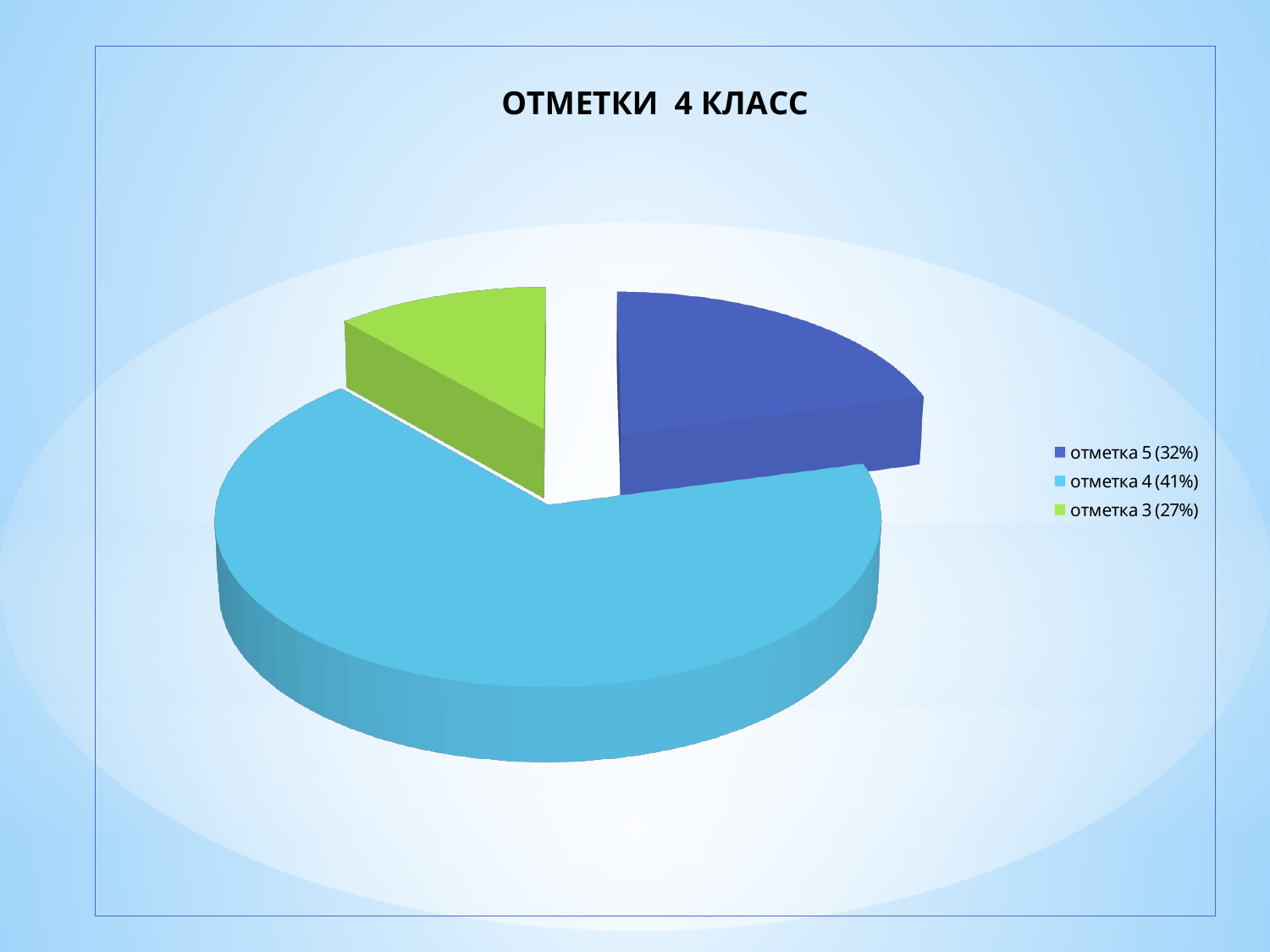
Which is larger, the share for отметка 5 or the share for отметка 3? отметка 5 Which category has the largest share of the pie? отметка 4 What kind of chart is shown on the slide? pie chart Which category has the smallest share of the pie? отметка 3 What is the title of the chart? ОТМЕТКИ 4 КЛАСС What colour is the slice for отметка 3? green How many slices does the pie chart have? 3